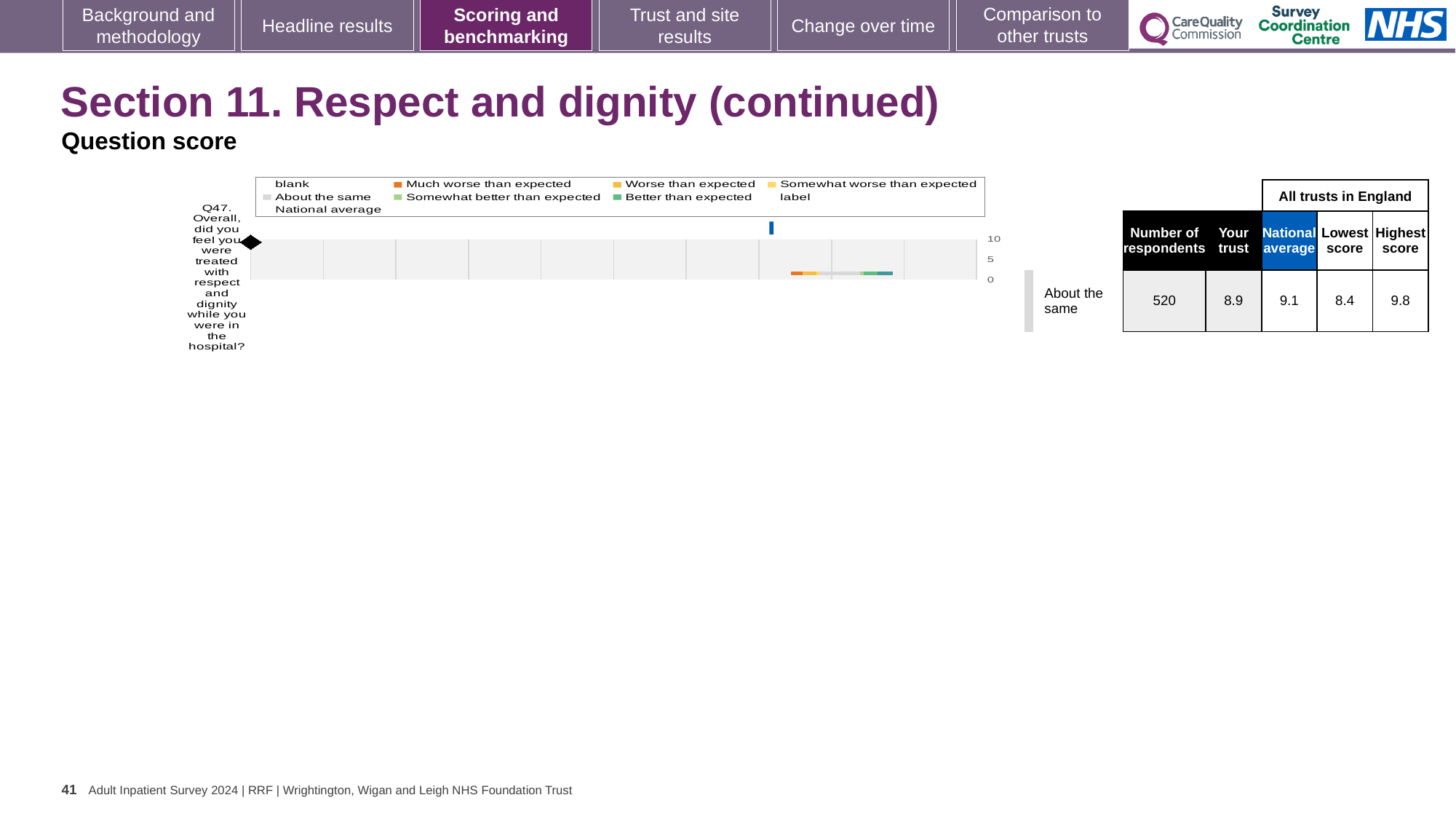
What is the national average score for Q47? 9.1 How many respondents answered Q47? 520 What is the difference between the national average and the trust's score for Q47? 0.2 What is the lowest score among all trusts in England for Q47? 8.4 What is the difference between the highest score and the lowest score for Q47? 1.4 How many questions (categories) are plotted on the chart? 1 What kind of chart is shown on the slide for Q47? bar chart What is the 'Your trust' score for Q47? 8.9 Which benchmark category is Q47 assigned to on the slide? About the same What is the highest value shown on the chart's numeric axis? 10 Which is larger for Q47, the trust's score or the national average? national average What is the highest score among all trusts in England for Q47? 9.8